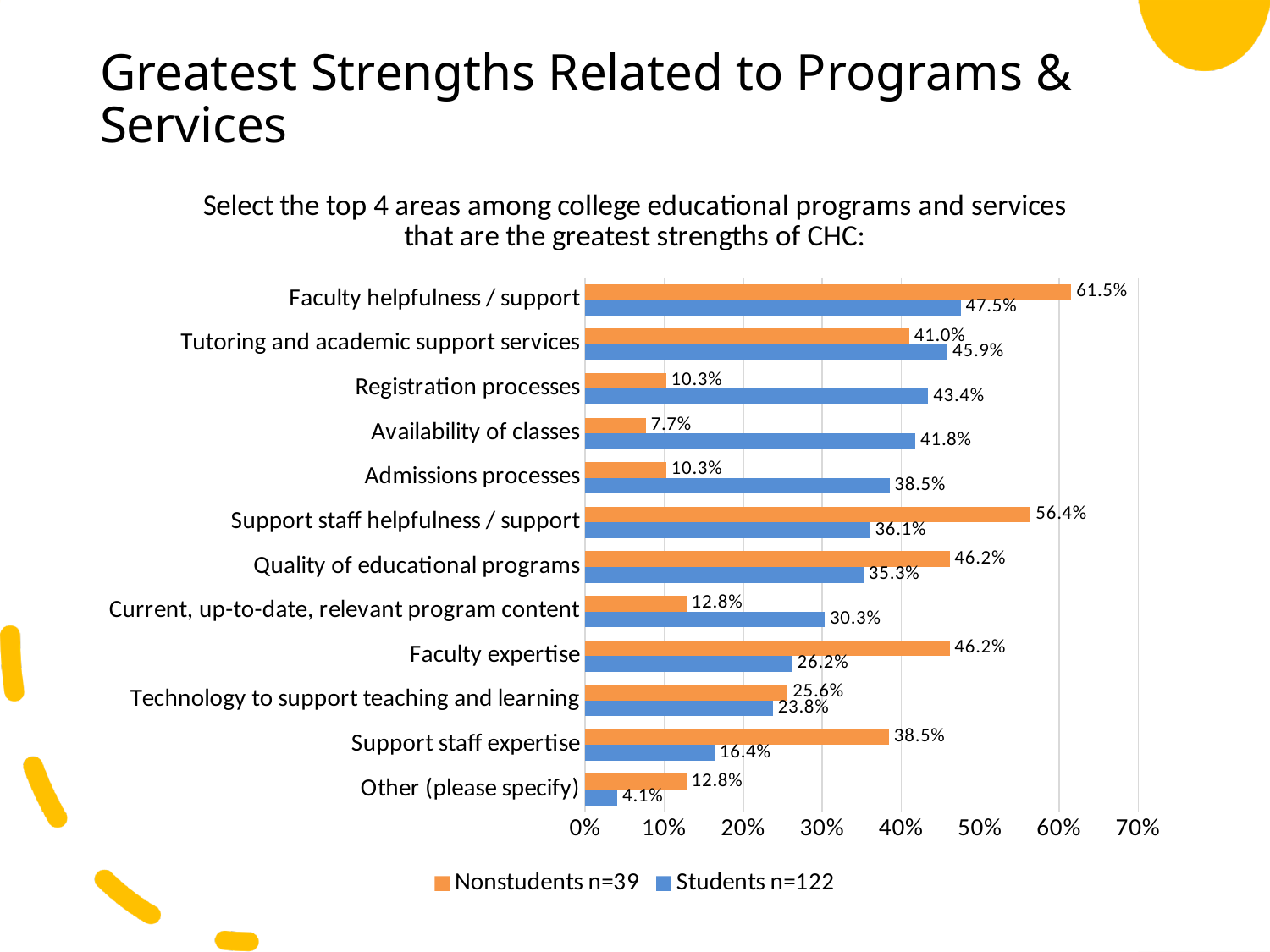
What percentage of Students selected Registration processes? 43.4% Which colour represents Nonstudents in the chart? Orange What percentage of Students selected Faculty helpfulness / support? 47.5% What is the sample size for Students shown in the legend? n=122 What is the difference between the Nonstudents and Students values for Availability of classes? 34.1% What kind of chart is shown on the slide? Bar chart How many categories are shown on the chart? 12 What percentage of Nonstudents selected Support staff expertise? 38.5% For Quality of educational programs, which group has the larger value, Nonstudents or Students? Nonstudents Which category has the highest value for Nonstudents? Faculty helpfulness / support Which category has the lowest value for Students? Other (please specify) How many series does the legend list? 2